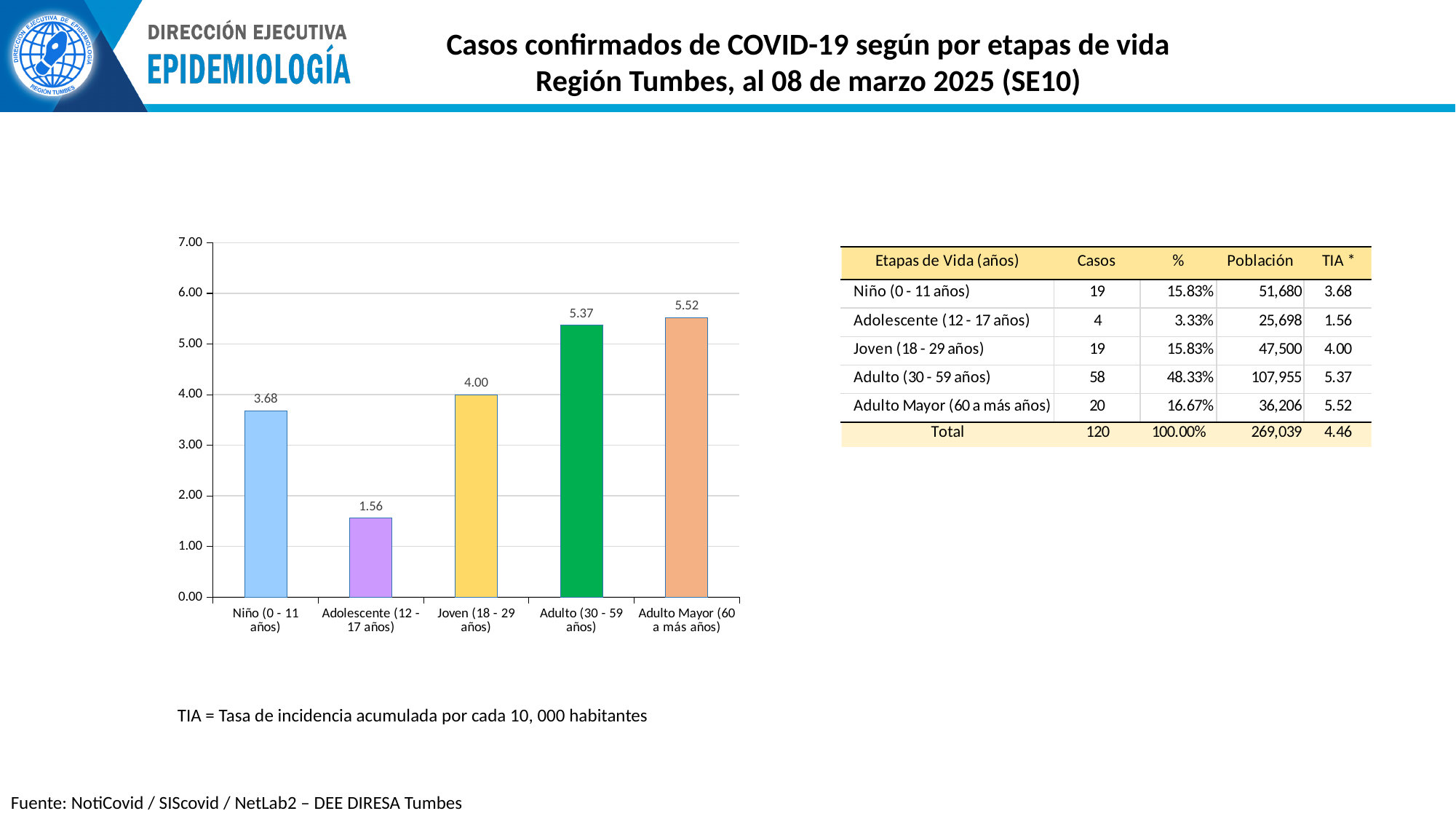
What is the difference between the values for Adulto Mayor (60 a más años) and Adolescente (12 - 17 años)? 3.96 Which category has the lowest bar? Adolescente (12 - 17 años) Is the value for Adulto (30 - 59 años) greater or less than 5.00? greater What is the value of the bar for Adulto (30 - 59 años)? 5.37 What kind of chart is shown on the slide? bar chart Which category has the highest bar? Adulto Mayor (60 a más años) Which is larger, the value for Niño (0 - 11 años) or the value for Joven (18 - 29 años)? Joven (18 - 29 años) How many categories are shown on the x axis of the chart? 5 What is the value of the bar for Adolescente (12 - 17 años)? 1.56 What is the value of the bar for Niño (0 - 11 años)? 3.68 What colour is the bar for Adulto (30 - 59 años)? green What is the value of the bar for Joven (18 - 29 años)? 4.00